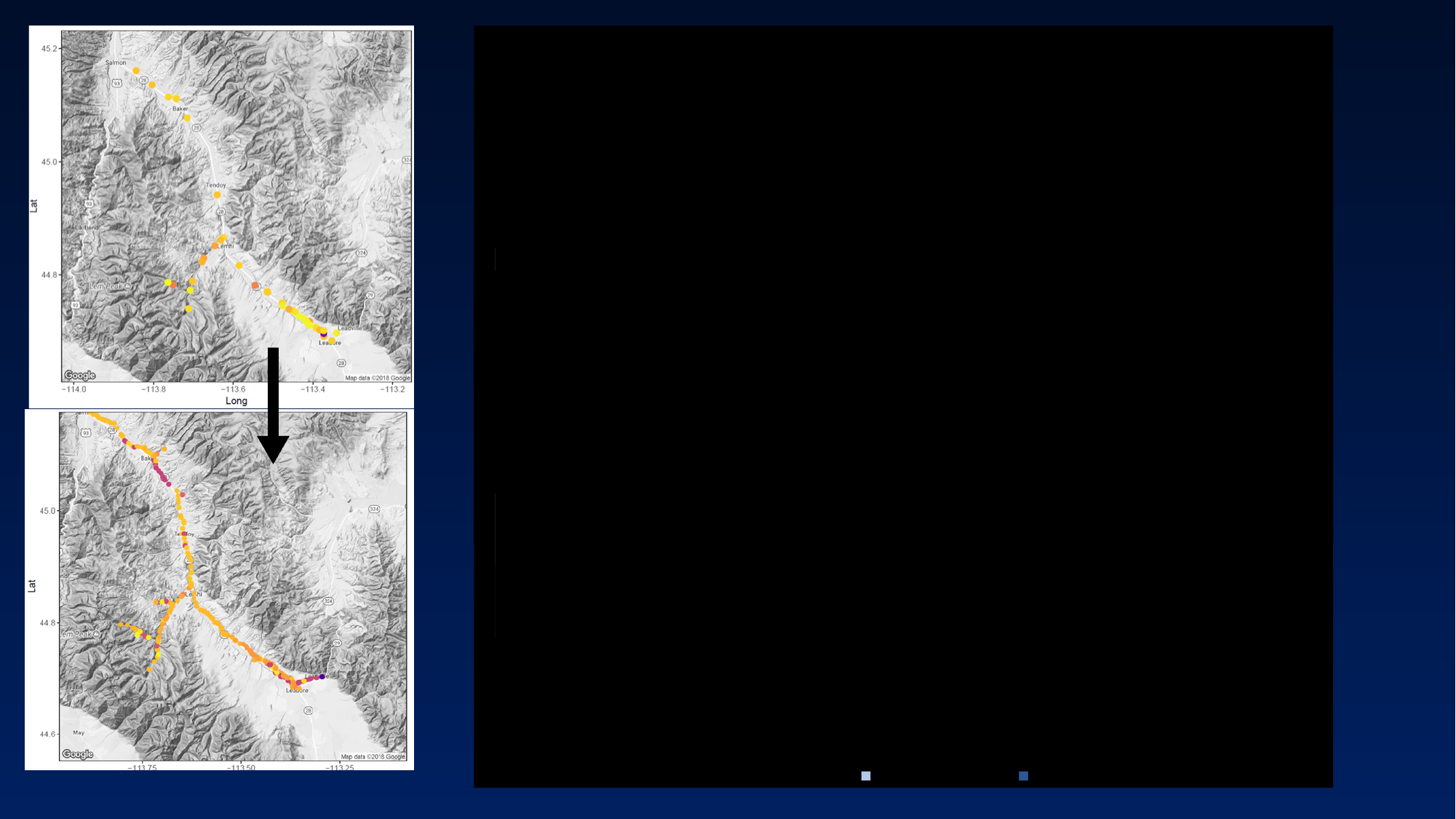
How many map charts are shown on the left side of the slide? 2 On the bottom-left map chart, is the latitude of the points near Baker greater or less than 45.0? greater On the top-left map chart, is the latitude of the point near Salmon greater or less than 45.0? greater On the bottom-left map chart, is the latitude of the points near Lemhi greater or less than 45.0? less What is the label on the y-axis of the top-left map chart? Lat What is the label on the x-axis of the top-left map chart? Long What is the lowest latitude tick shown on the y-axis of the bottom-left map chart? 44.6 What is the highest latitude tick shown on the y-axis of the top-left map chart? 45.2 What kind of chart is the top-left chart on the slide? Scatter plot of points on a map